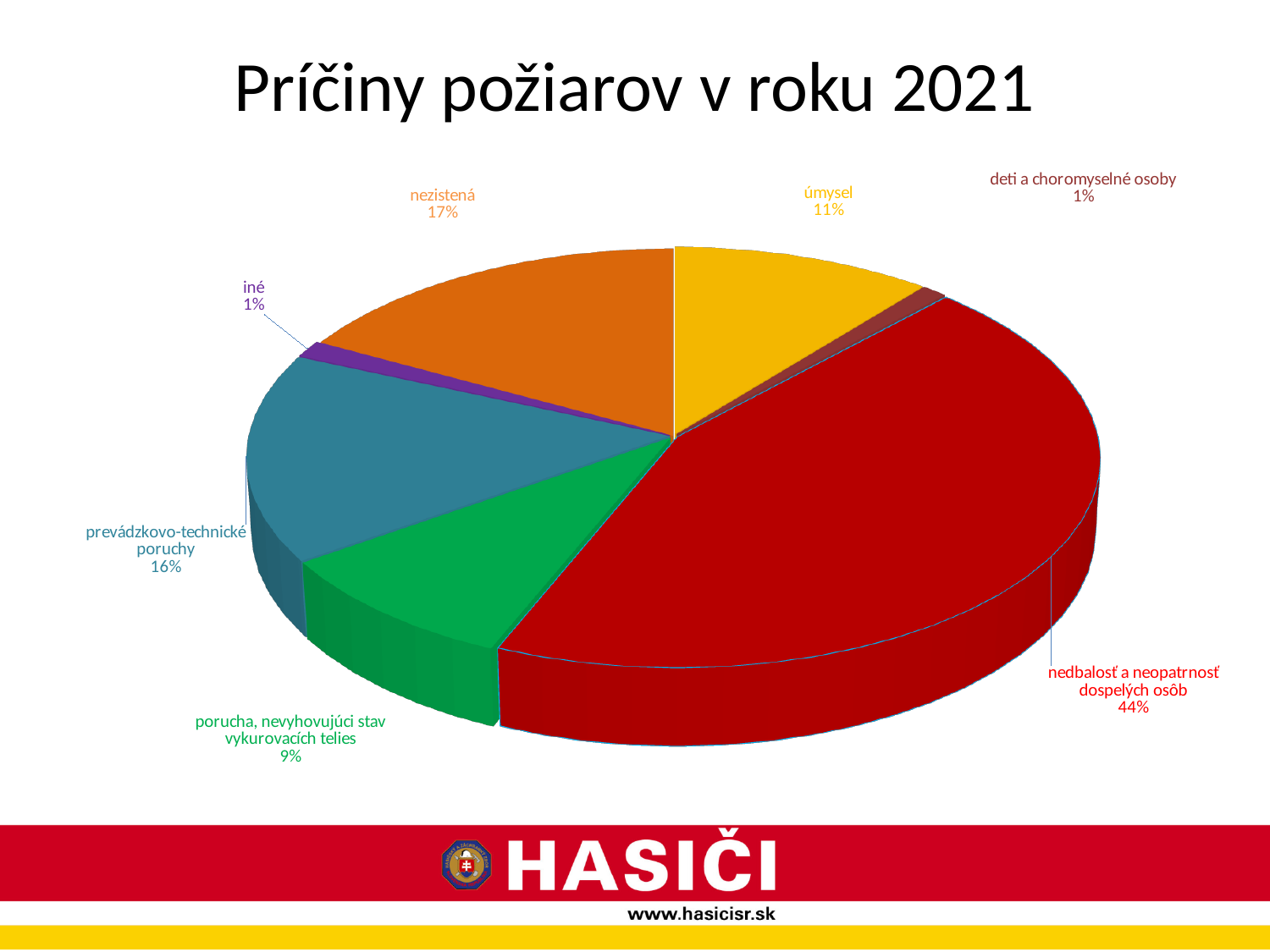
Which cause has the largest share of the pie? nedbalosť a neopatrnosť dospelých osôb What percentage is shown for "úmysel"? 11% What is the difference in percentage points between "nezistená" and "úmysel"? 6 How many slices does the pie chart have? 7 What percentage is shown for "porucha, nevyhovujúci stav vykurovacích telies"? 9% What percentage is shown for "nezistená"? 17% What is the title of the chart? Príčiny požiarov v roku 2021 What percentage is shown for "prevádzkovo-technické poruchy"? 16% What percentage is shown for "deti a choromyselné osoby"? 1% What share of the pie is labelled "nedbalosť a neopatrnosť dospelých osôb"? 44% Which is larger, the share for "prevádzkovo-technické poruchy" or the share for "porucha, nevyhovujúci stav vykurovacích telies"? prevádzkovo-technické poruchy What kind of chart is shown on the slide? pie chart